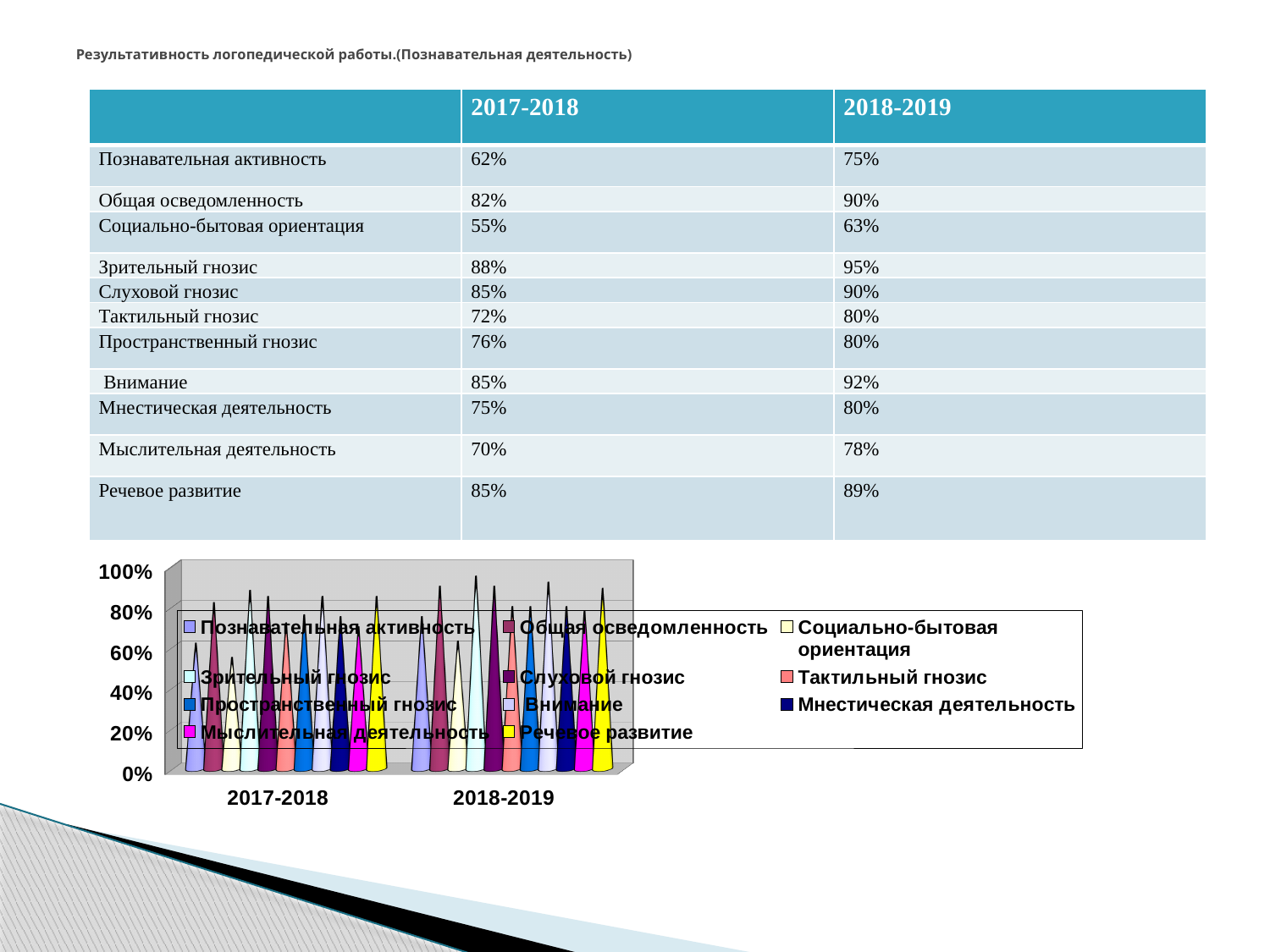
What are the two categories on the x axis of the chart? 2017-2018 and 2018-2019 Which is larger in 2017-2018: Общая осведомленность or Тактильный гнозис? Общая осведомленность Which series has the lowest value in 2017-2018? Социально-бытовая ориентация What kind of chart is shown at the bottom of the slide? bar chart What is the value for Познавательная активность in 2017-2018? 62% What is the value for Зрительный гнозис in 2018-2019? 95% Do the values for each series rise or fall from 2017-2018 to 2018-2019? rise How many series does the chart legend list? 11 By how much did Познавательная активность increase from 2017-2018 to 2018-2019? 13% How many categories are shown on the x axis of the chart? 2 What is the highest value shown on the chart's y axis? 100% Which series has the highest value in 2018-2019? Зрительный гнозис